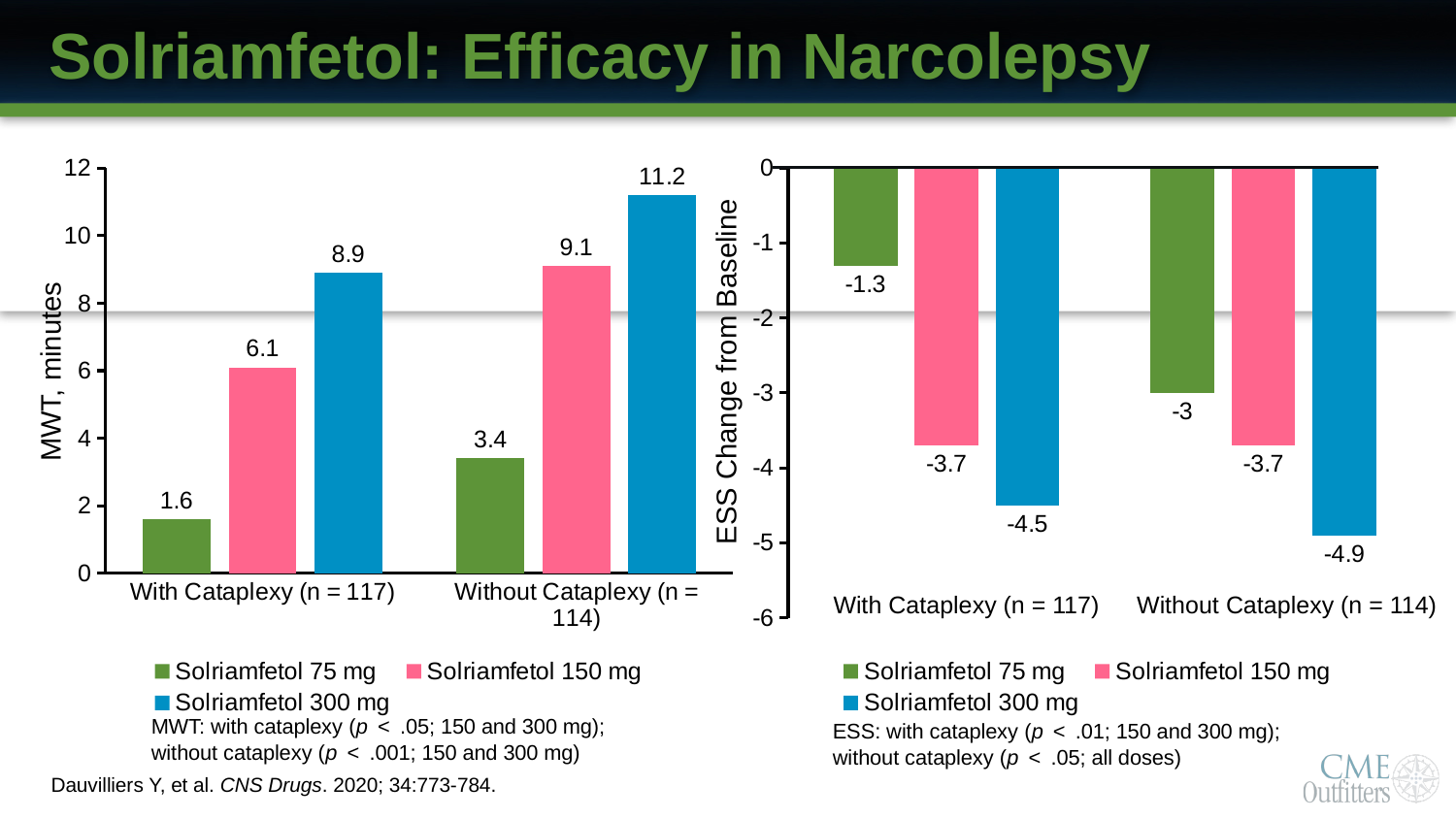
In the left chart (MWT, minutes), is the Solriamfetol 150 mg value larger in the With Cataplexy group or the Without Cataplexy group? Without Cataplexy In the left chart (MWT, minutes), which dose has the lowest value in the Without Cataplexy (n = 114) group? Solriamfetol 75 mg In the right chart (ESS Change from Baseline), what is the value for Solriamfetol 300 mg in the Without Cataplexy (n = 114) group? -4.9 What kind of chart is the left chart (MWT, minutes)? Bar chart In the left chart (MWT, minutes), what is the difference between the Solriamfetol 300 mg and Solriamfetol 75 mg values in the Without Cataplexy (n = 114) group? 7.8 In the right chart (ESS Change from Baseline), what is the difference between the Solriamfetol 75 mg values for the With Cataplexy and Without Cataplexy groups? 1.7 In the right chart (ESS Change from Baseline), what is the value for Solriamfetol 150 mg in the With Cataplexy (n = 117) group? -3.7 How many series does the legend of the right chart (ESS Change from Baseline) list? 3 In the left chart (MWT, minutes), what is the value for Solriamfetol 75 mg in the With Cataplexy (n = 117) group? 1.6 In the left chart (MWT, minutes), is the value for Solriamfetol 150 mg in the With Cataplexy (n = 117) group greater or less than 8? less In the left chart (MWT, minutes), what is the value for Solriamfetol 300 mg in the Without Cataplexy (n = 114) group? 11.2 In the left chart (MWT, minutes), which dose has the highest value in the With Cataplexy (n = 117) group? Solriamfetol 300 mg